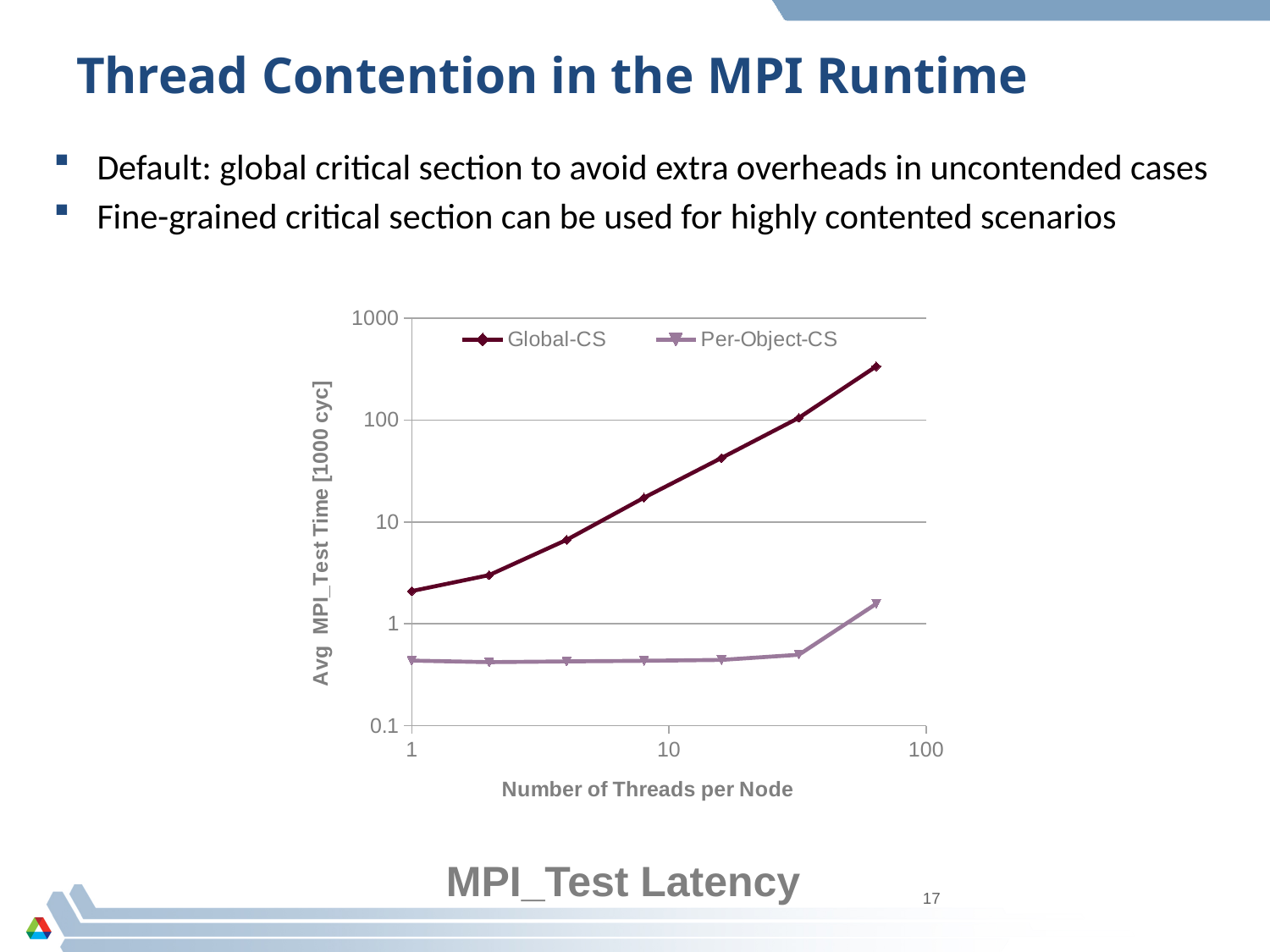
How many data points are plotted for the Global-CS series? 7 What are the names of the two series in the chart legend? Global-CS and Per-Object-CS Is the Global-CS value at 1 thread per node greater or less than 1? greater Which series has the higher MPI_Test time at the largest number of threads per node shown? Global-CS What is the title of the chart's y axis? Avg MPI_Test Time [1000 cyc] Does the Global-CS MPI_Test time rise or fall as the number of threads per node increases? rise How many series does the chart legend list? 2 Which series has the lowest MPI_Test time across the chart? Per-Object-CS What kind of chart is shown on the slide? line chart Which series has the higher MPI_Test time at 1 thread per node, Global-CS or Per-Object-CS? Global-CS Is the Global-CS value at its rightmost data point greater or less than 100? greater Is the Per-Object-CS value at 1 thread per node greater or less than 1? less